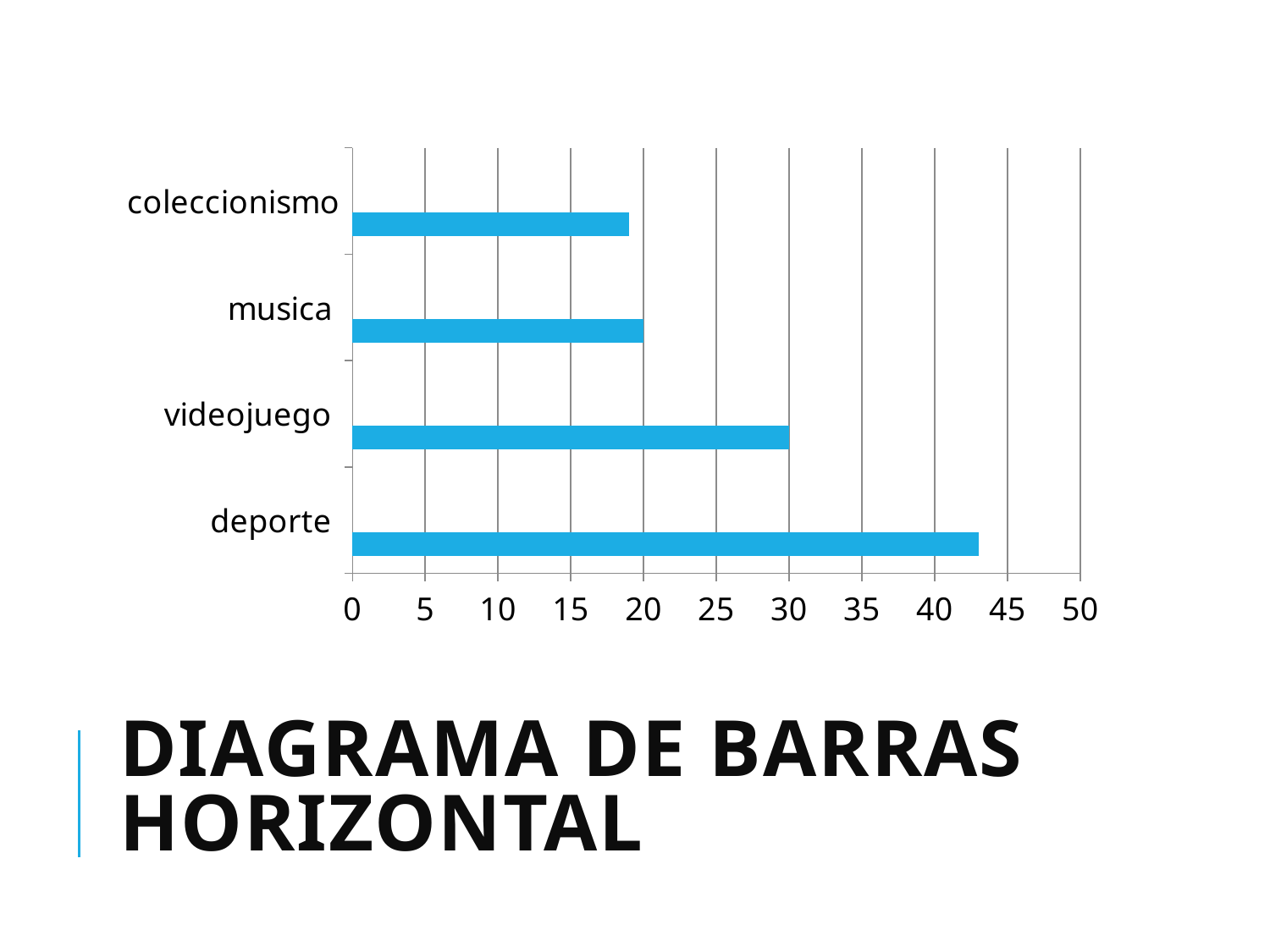
Is the value for deporte greater or less than 40? greater Which is larger, the value for videojuego or the value for musica? videojuego Which is larger, the value for deporte or the value for coleccionismo? deporte What is the difference between the values for videojuego and musica? 10 Which category has the highest value? deporte What kind of chart is shown on the slide? bar chart What is the value for videojuego? 30 What is the value for musica? 20 Is the value for coleccionismo greater or less than 20? less Is the value for deporte greater or less than 45? less What is the title text shown on the slide? DIAGRAMA DE BARRAS HORIZONTAL How many categories are shown in the chart? 4